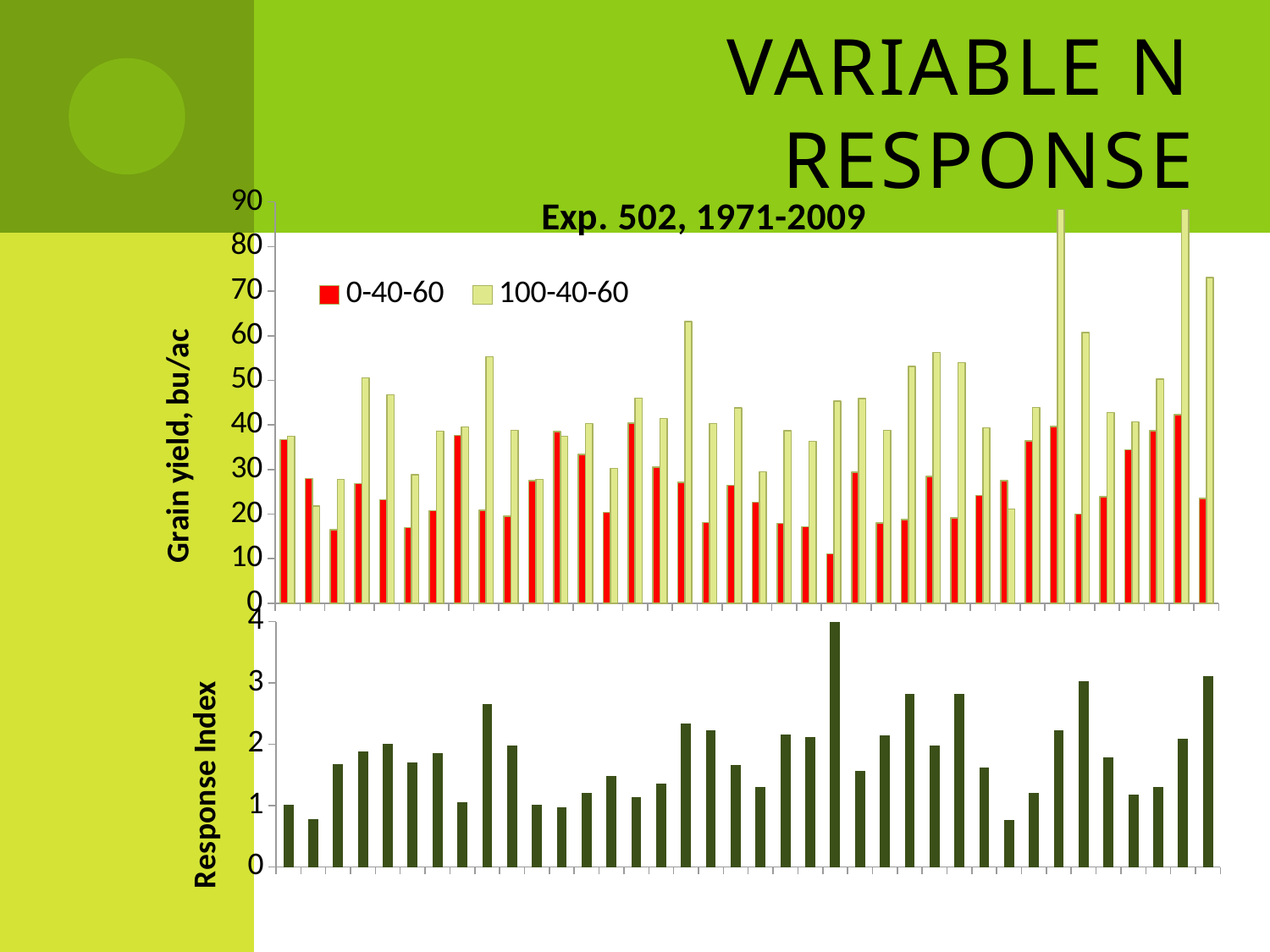
What is the y-axis label of the top chart 'Exp. 502, 1971-2009'? Grain yield, bu/ac What is the y-axis label of the bottom chart? Response Index In the top chart 'Exp. 502, 1971-2009', is the tallest 100-40-60 bar greater or less than 80? greater What type of chart is the bottom chart with the 'Response Index' axis? bar chart How many series does the legend of the top chart 'Exp. 502, 1971-2009' list? 2 What is the highest value shown on the y-axis of the top chart 'Exp. 502, 1971-2009'? 90 In the bottom chart, is the lowest Response Index value greater or less than 1? less What type of chart is the top chart titled 'Exp. 502, 1971-2009'? bar chart In the top chart 'Exp. 502, 1971-2009', which series generally has the higher grain yield, 0-40-60 or 100-40-60? 100-40-60 In the bottom chart, is the highest Response Index value greater or less than 3? greater